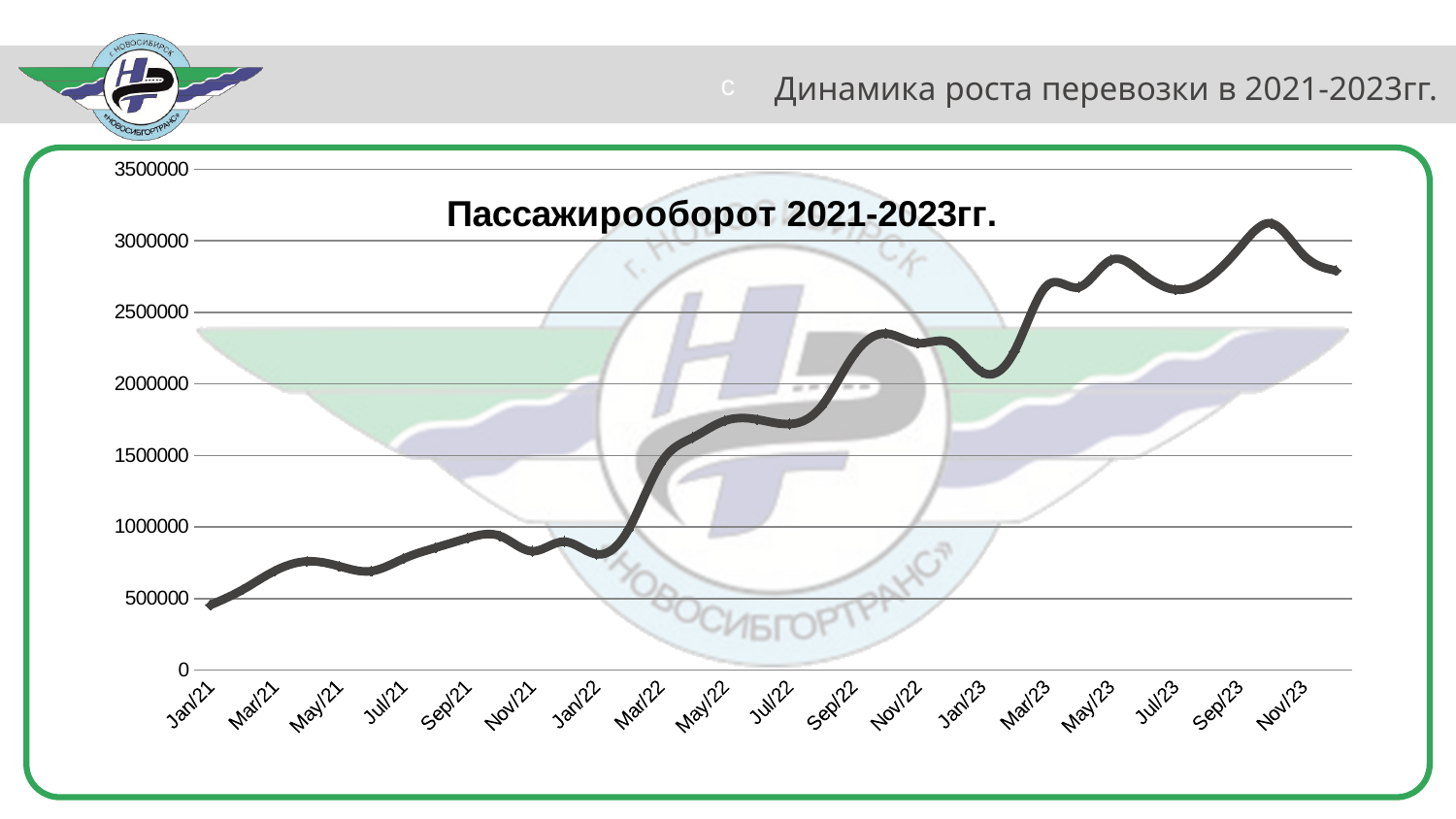
How many month labels are shown on the x axis? 18 Which month has the lowest value on the chart? Jan/21 What kind of chart is shown on the slide? line chart Is the value for May/22 greater or less than 1500000? greater Is the value for Mar/21 greater or less than 1000000? less Is the value for Mar/23 greater or less than 2500000? greater What is the title of the chart? Пассажирооборот 2021-2023гг. Which is larger, the value for Sep/21 or the value for Sep/22? Sep/22 Overall, do the values rise or fall from Jan/21 to Nov/23? rise